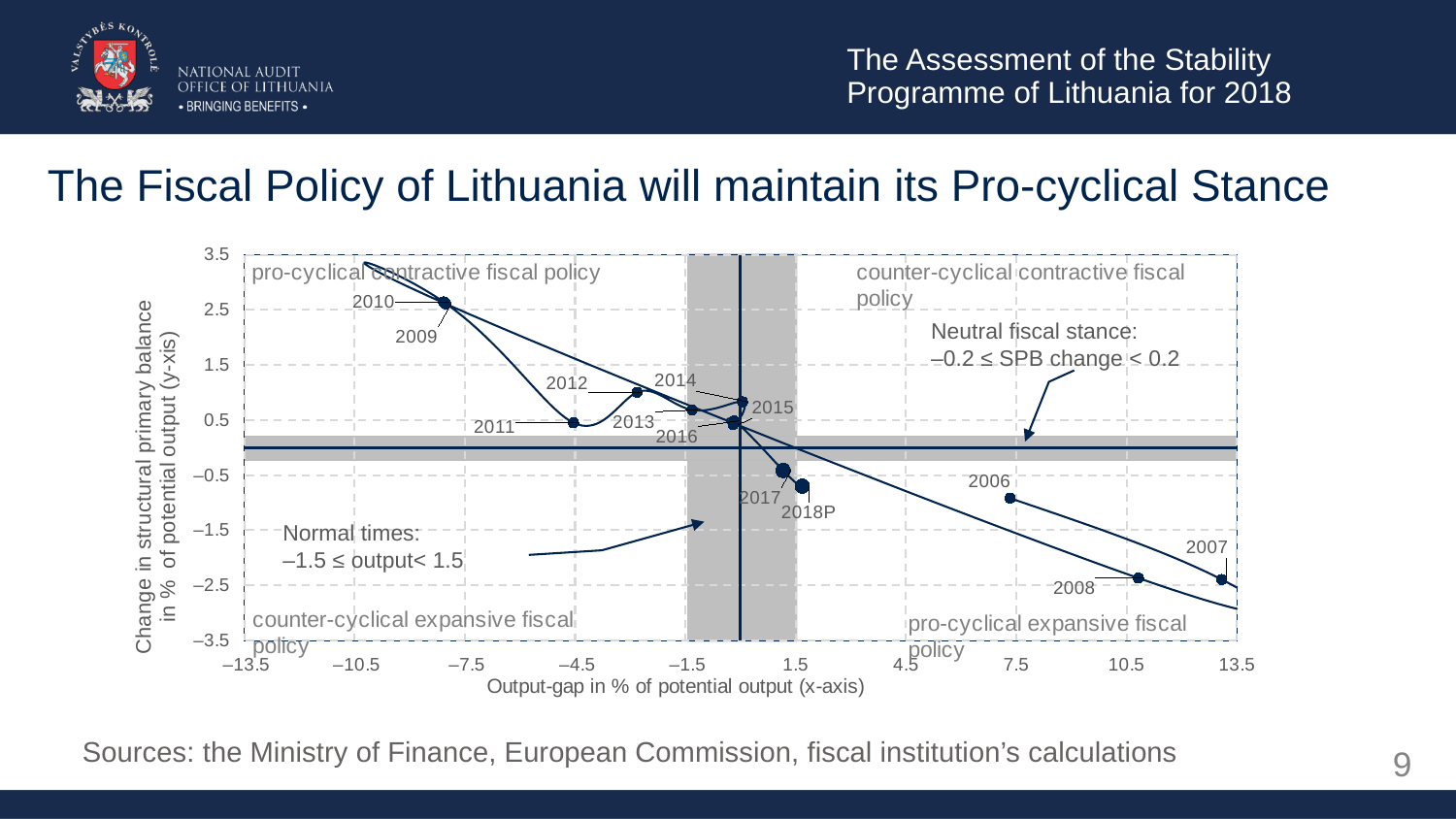
Which year has the highest output gap on the chart? 2007 Is the change in structural primary balance for 2007 greater or less than -1.5? less What kind of chart is shown on the slide? scatter chart How many year-labelled data points are plotted on the chart? 13 Is the change in structural primary balance for 2006 greater or less than 0.5? less Is the output gap for 2008 greater or less than 7.5? greater Which year has the higher change in structural primary balance, 2010 or 2007? 2010 What is the label of the x-axis? Output-gap in % of potential output (x-axis) Which quadrant label appears in the bottom-right of the chart? pro-cyclical expansive fiscal policy Which year has the larger output gap, 2007 or 2011? 2007